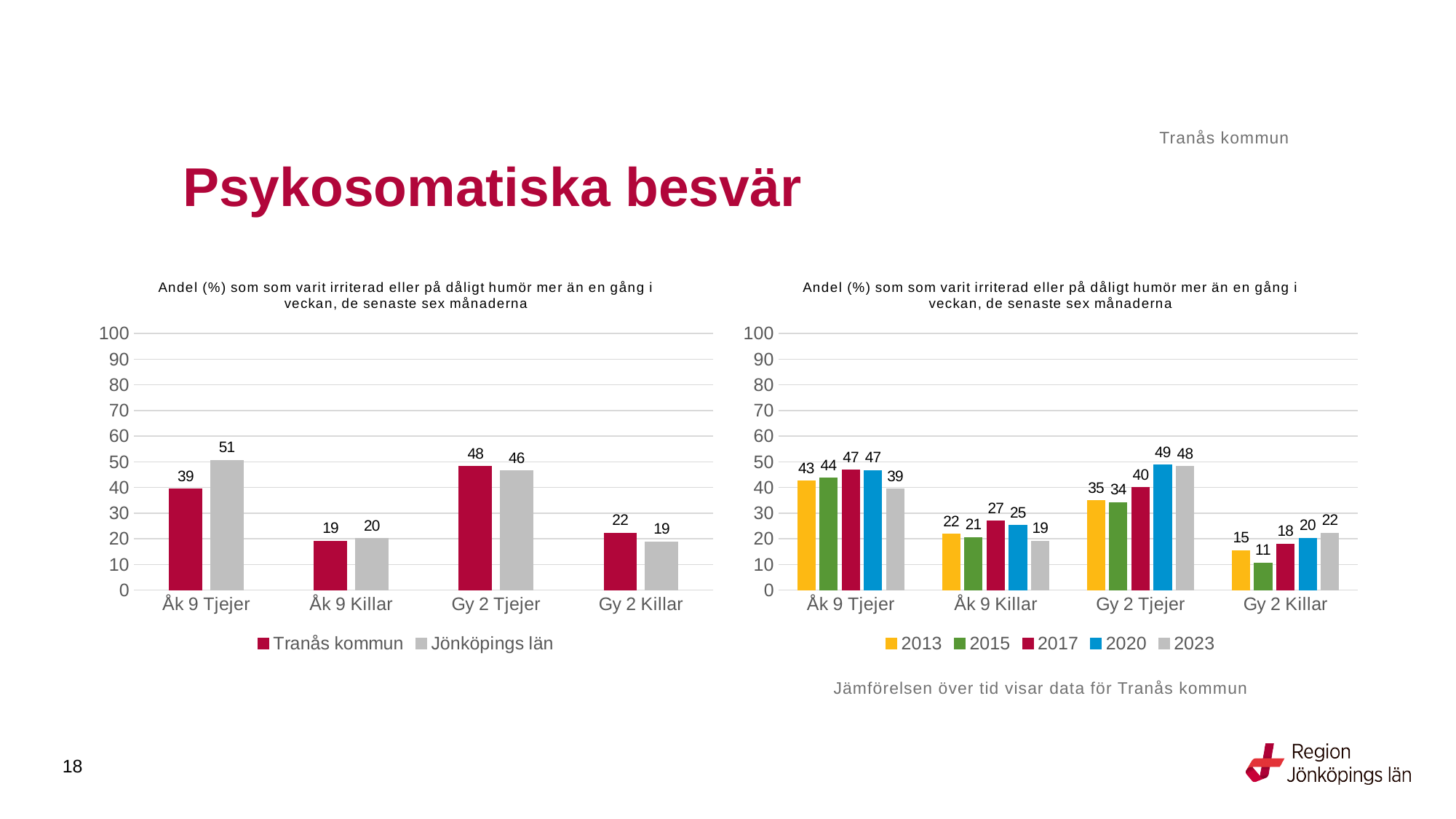
In the left chart, what is the value for Tranås kommun for Åk 9 Tjejer? 39 In the right chart, what is the value for 2015 for Gy 2 Killar? 11 What kind of chart is the right chart? bar chart In the left chart, how many series does the legend list? 2 In the left chart, which category has the highest value for Jönköpings län? Åk 9 Tjejer In the right chart, do the values for Gy 2 Killar rise or fall from 2015 to 2023? rise In the left chart, what is the value for Jönköpings län for Gy 2 Killar? 19 In the left chart, what is the difference between Jönköpings län and Tranås kommun for Åk 9 Tjejer? 12 In the right chart, what is the value for 2020 for Gy 2 Tjejer? 49 In the left chart, which is larger for Gy 2 Tjejer: Tranås kommun or Jönköpings län? Tranås kommun In the right chart, how many series does the legend list? 5 In the right chart, which year has the lowest value for Åk 9 Killar? 2023